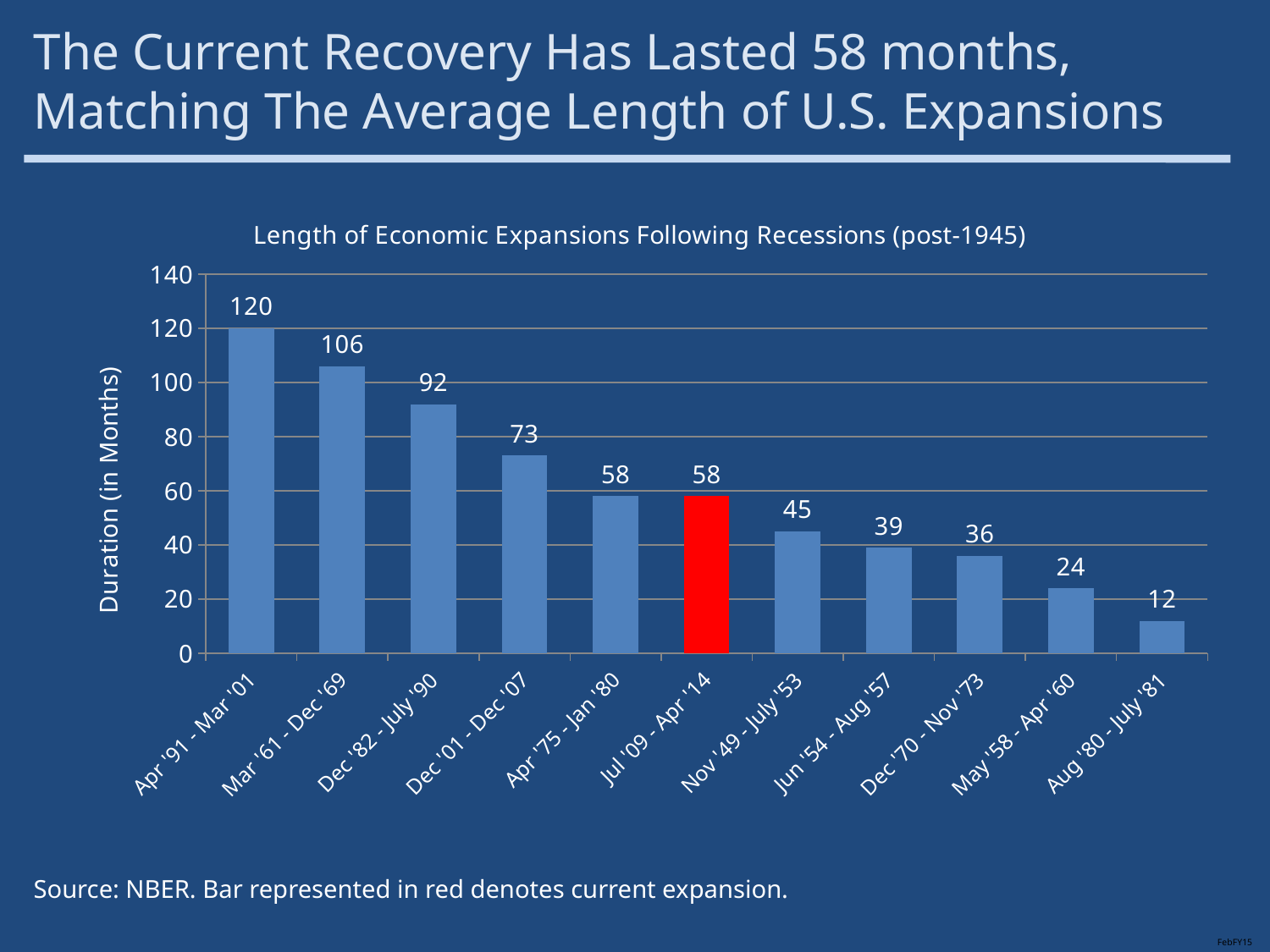
What is the duration in months for the Dec '70 - Nov '73 expansion? 36 What is the difference in months between the Mar '61 - Dec '69 expansion and the Dec '82 - July '90 expansion? 14 Which expansion period has the shortest duration? Aug '80 - July '81 What kind of chart is shown on the slide? Bar chart What is the duration in months for the Apr '91 - Mar '01 expansion? 120 Which expansion lasted longer, Nov '49 - July '53 or Jun '54 - Aug '57? Nov '49 - July '53 How many expansion periods are shown in the chart? 11 Which expansion period is represented by the red bar? Jul '09 - Apr '14 Do the bar values rise or fall from left to right along the x axis? Fall What is the duration in months for the Jul '09 - Apr '14 expansion? 58 Is the value for Dec '01 - Dec '07 greater or less than 80? less Which expansion period has the longest duration? Apr '91 - Mar '01